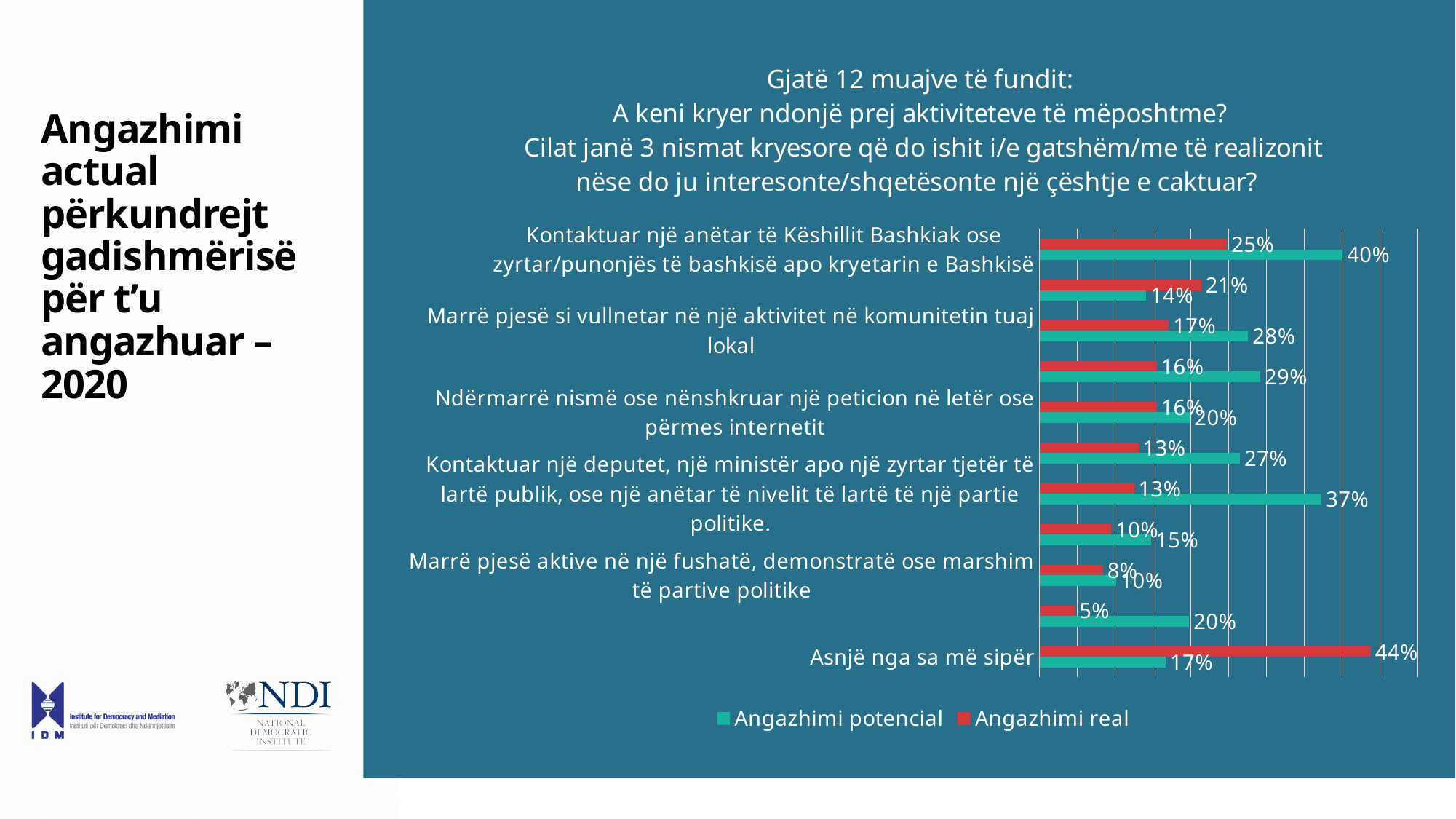
What is the value of Angazhimi potencial for 'Asnjë nga sa më sipër'? 17% What is the value of Angazhimi real for 'Asnjë nga sa më sipër'? 44% For 'Asnjë nga sa më sipër', which is larger: Angazhimi potencial or Angazhimi real? Angazhimi real What is the value of Angazhimi real for 'Kontaktuar një anëtar të Këshillit Bashkiak ose zyrtar/punonjës të bashkisë apo kryetarin e Bashkisë'? 25% What type of chart is shown on the slide? Bar chart Which category has the highest Angazhimi real value? Asnjë nga sa më sipër What is the value of Angazhimi potencial for 'Kontaktuar një deputet, një ministër apo një zyrtar tjetër të lartë publik, ose një anëtar të nivelit të lartë të një partie politike'? 37% Which category has the highest Angazhimi potencial value? Kontaktuar një anëtar të Këshillit Bashkiak ose zyrtar/punonjës të bashkisë apo kryetarin e Bashkisë What is the difference between Angazhimi potencial and Angazhimi real for 'Kontaktuar një deputet, një ministër apo një zyrtar tjetër të lartë publik, ose një anëtar të nivelit të lartë të një partie politike'? 24% What is the value of Angazhimi real for 'Marrë pjesë aktive në një fushatë, demonstratë ose marshim të partive politike'? 8% How many series does the legend list? 2 What is the value of Angazhimi potencial for 'Kontaktuar një anëtar të Këshillit Bashkiak ose zyrtar/punonjës të bashkisë apo kryetarin e Bashkisë'? 40%